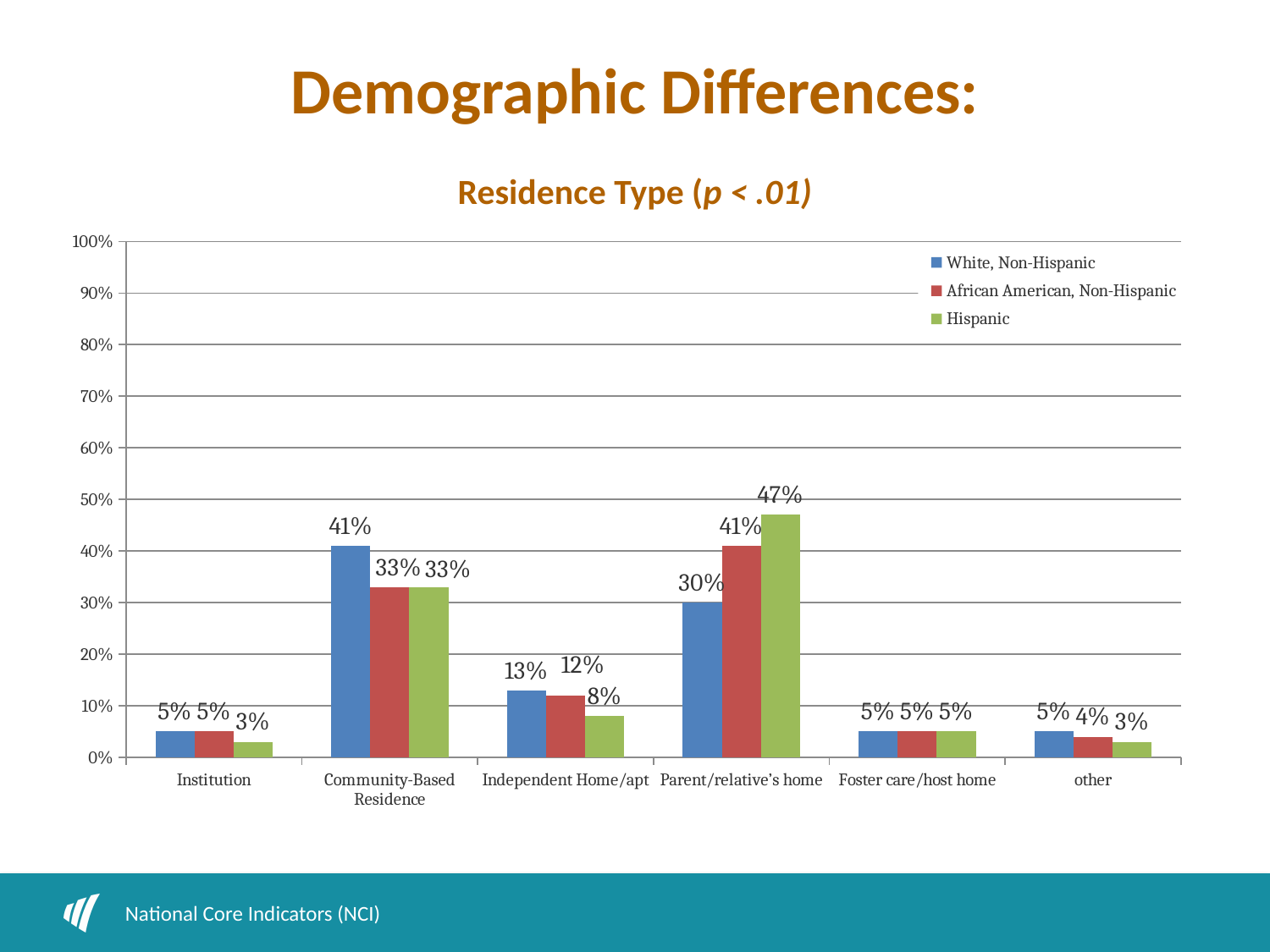
What is the difference between the Hispanic and White, Non-Hispanic values in the Parent/relative's home category? 17% Which category has the lowest value for the White, Non-Hispanic series? Institution, Foster care/host home and other (all 5%) What is the value for Hispanic in the Parent/relative's home category? 47% What is the value for African American, Non-Hispanic in the Independent Home/apt category? 12% Which series is shown in green in the legend? Hispanic How many residence type categories are shown on the x axis? 6 What kind of chart is shown on the slide? Bar chart What is the value for White, Non-Hispanic in the Community-Based Residence category? 41% Is the value for African American, Non-Hispanic in the Parent/relative's home category greater or less than 40%? greater How many series does the legend list? 3 In the Community-Based Residence category, which is larger: White, Non-Hispanic or Hispanic? White, Non-Hispanic Which category has the highest value for the Hispanic series? Parent/relative's home